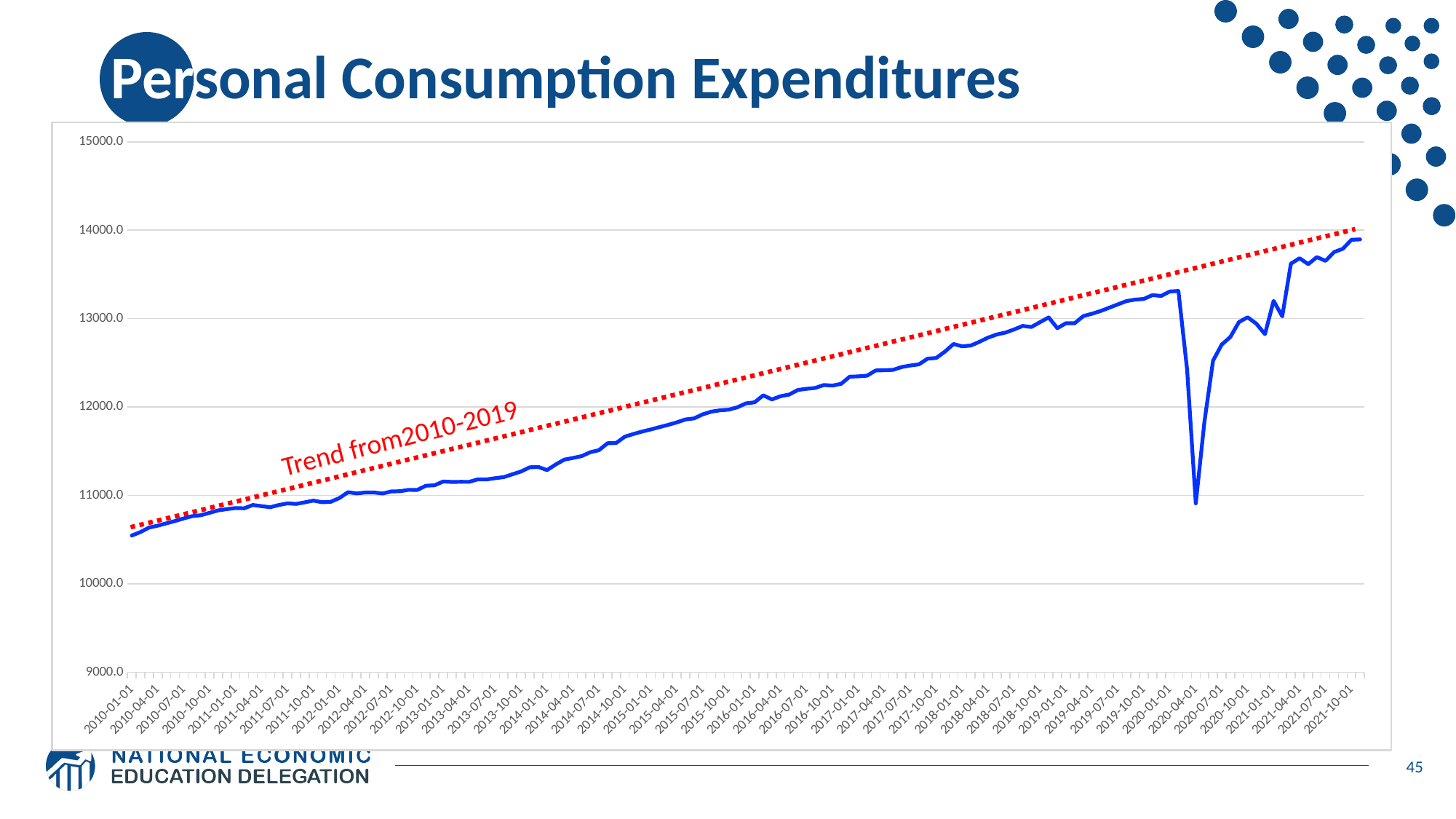
Is the lowest value in 2020 greater or less than 12000? less Is the value at 2018-01-01 greater or less than 12000? greater Overall, do the plotted values rise or fall from 2010-01-01 to 2021-10-01? rise What is the title of the slide's chart? Personal Consumption Expenditures What is the highest value shown on the vertical axis? 15000.0 What kind of chart is shown on the slide? line chart Which is larger, the value at 2019-10-01 or the value at 2020-04-01? 2019-10-01 Is the value at 2010-01-01 greater or less than 11000? less What does the label on the red dotted line say? Trend from2010-2019